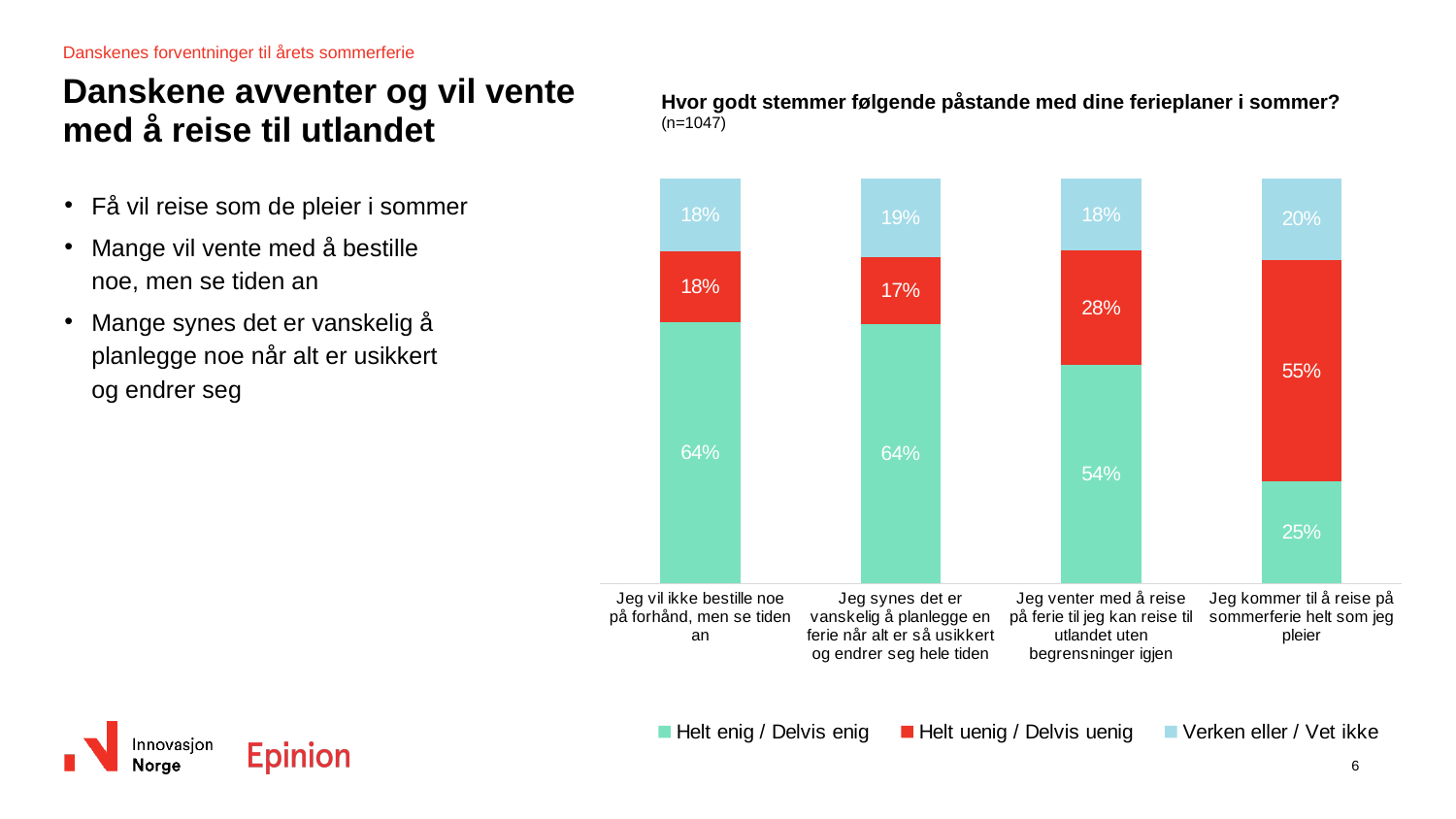
What is the 'Helt uenig / Delvis uenig' value for 'Jeg venter med å reise på ferie til jeg kan reise til utlandet uten begrensninger igjen'? 28% Which is larger: the 'Helt uenig / Delvis uenig' value for 'Jeg venter med å reise på ferie til jeg kan reise til utlandet uten begrensninger igjen' or for 'Jeg synes det er vanskelig å planlegge en ferie når alt er så usikkert og endrer seg hele tiden'? Jeg venter med å reise på ferie til jeg kan reise til utlandet uten begrensninger igjen What is the difference between the 'Helt enig / Delvis enig' values for 'Jeg vil ikke bestille noe på forhånd, men se tiden an' and 'Jeg venter med å reise på ferie til jeg kan reise til utlandet uten begrensninger igjen'? 10% Which statement has the highest 'Helt uenig / Delvis uenig' share? Jeg kommer til å reise på sommerferie helt som jeg pleier How many series does the legend list? 3 What is the 'Verken eller / Vet ikke' value for 'Jeg synes det er vanskelig å planlegge en ferie når alt er så usikkert og endrer seg hele tiden'? 19% Which statement has the lowest 'Helt enig / Delvis enig' share? Jeg kommer til å reise på sommerferie helt som jeg pleier What kind of chart is shown on the slide? Stacked bar chart What is the total of the stacked bar for 'Jeg vil ikke bestille noe på forhånd, men se tiden an'? 100% How many categories (statements) are shown on the x axis? 4 What is the sample size (n) stated under the chart title? n=1047 What is the 'Helt enig / Delvis enig' value for 'Jeg kommer til å reise på sommerferie helt som jeg pleier'? 25%